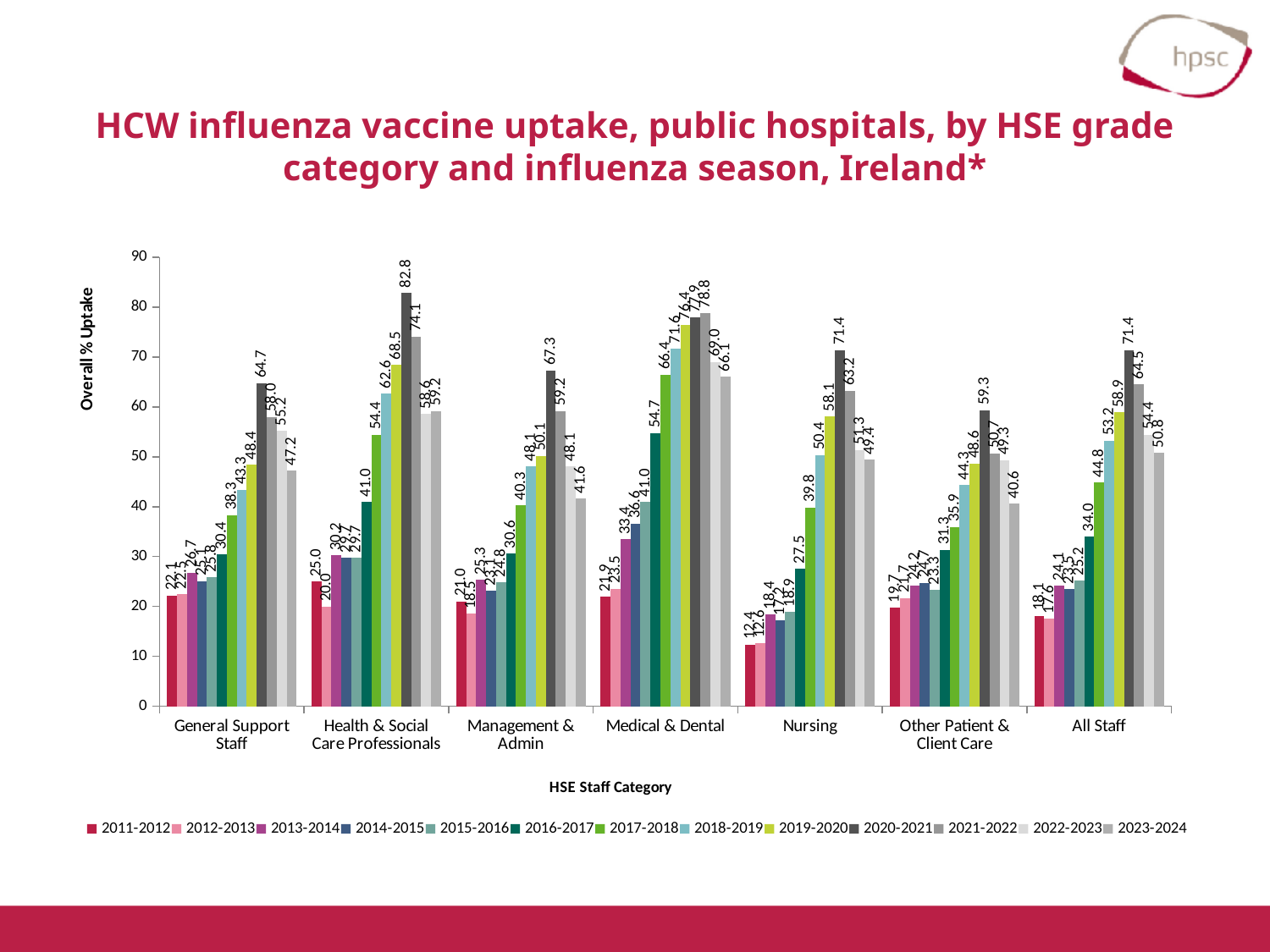
Is the Nursing uptake for the 2019-2020 season greater or less than 50? greater What is the overall % uptake for All Staff in the 2020-2021 season? 71.4 What is the difference between the All Staff uptake in 2020-2021 and in 2023-2024? 20.6 Which staff category has the lowest uptake in the 2020-2021 season? Other Patient & Client Care What is the overall % uptake for Health & Social Care Professionals in the 2020-2021 season? 82.8 How many HSE staff categories are shown on the x axis? 7 Which staff category and season has the highest uptake value on the chart? Health & Social Care Professionals, 2020-2021 (82.8) In the 2023-2024 season, which has the higher uptake: Medical & Dental or Nursing? Medical & Dental How many influenza seasons (series) does the legend list? 13 What is the title of the vertical axis? Overall % Uptake What is the overall % uptake for Medical & Dental in the 2021-2022 season? 78.8 What kind of chart is shown on the slide? Bar chart